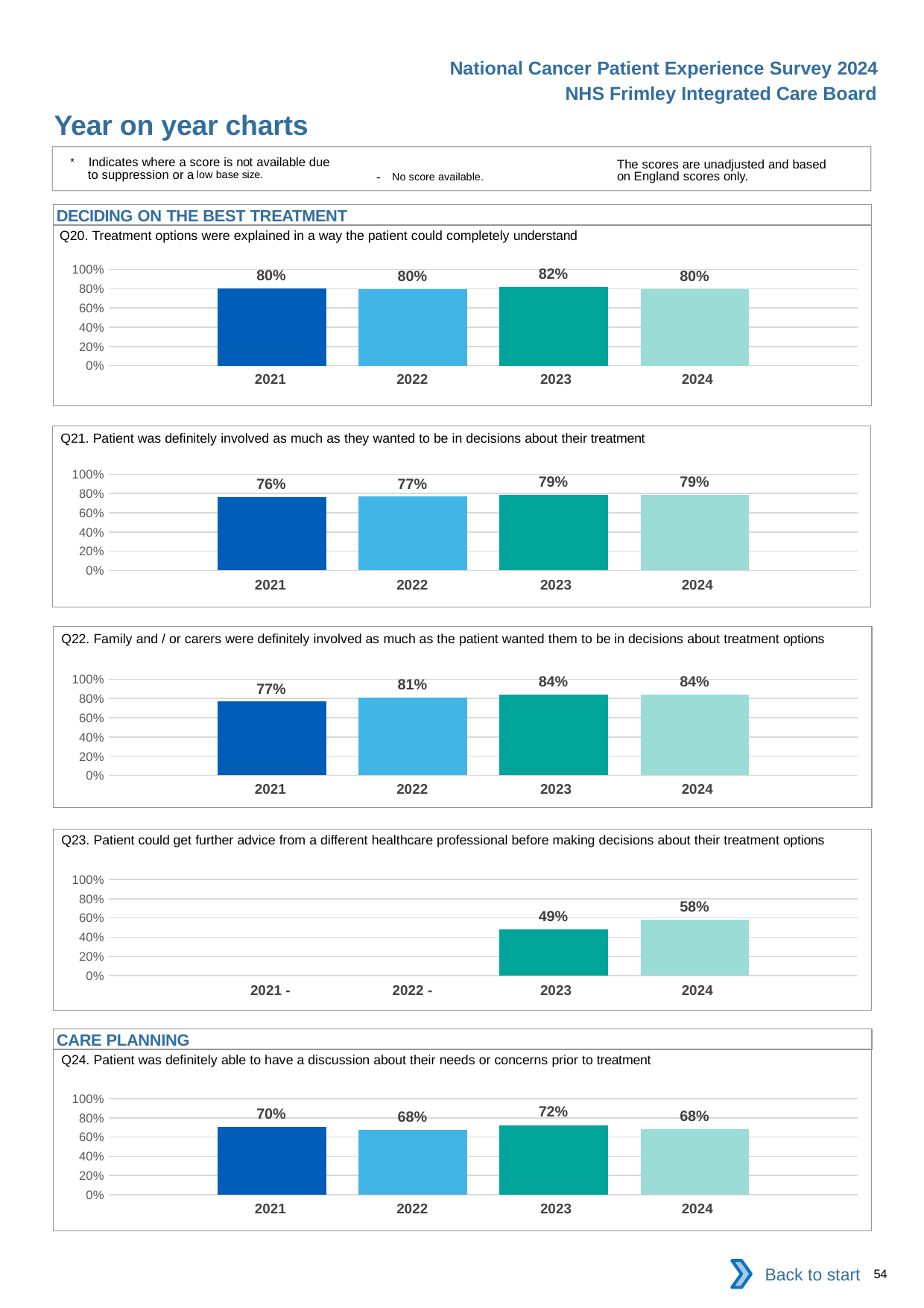
In the Q22 chart, do the values rise or fall from 2021 to 2023? rise Which section heading appears above the Q24 chart? CARE PLANNING In the Q23 chart, what is the value for 2024? 58% In the Q21 chart, which year has the lowest value? 2021 What kind of chart is the Q21 chart? bar chart In the Q24 chart, which year has the highest value? 2023 In the Q24 chart, is the value for 2022 larger or smaller than the value for 2021? smaller In the Q23 chart, how many years have a bar plotted? 2 In the Q20 chart, what is the value for 2023? 82% In the Q22 chart, what is the difference between the 2021 and 2024 values? 7 percentage points In the Q23 chart, is the value for 2023 greater or less than 60%? less In the Q21 chart, what is the difference between the 2022 and 2023 values? 2 percentage points